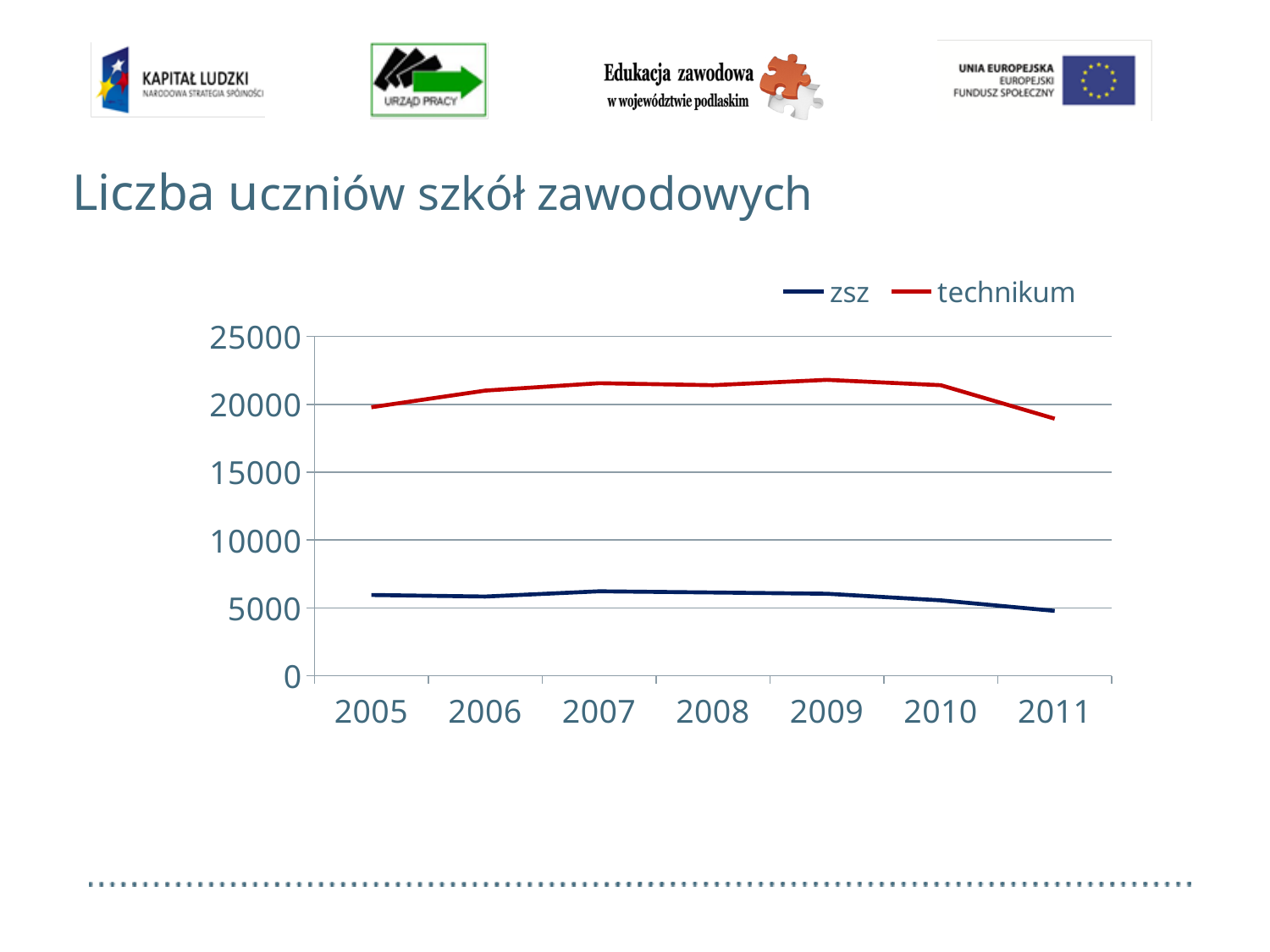
What is the title of the chart? Liczba uczniów szkół zawodowych Is the value for technikum in 2011 greater or less than 20000? less How many series does the legend list? 2 Which series has the higher value in 2011, zsz or technikum? technikum Which series is drawn in red? technikum Is the value for technikum in 2007 greater or less than 20000? greater In which year is the technikum series at its lowest? 2011 How many years are plotted along the x axis? 7 Does the zsz series rise or fall from 2009 to 2011? fall Is the value for zsz in 2005 greater or less than 5000? greater What kind of chart is shown on the slide? line chart